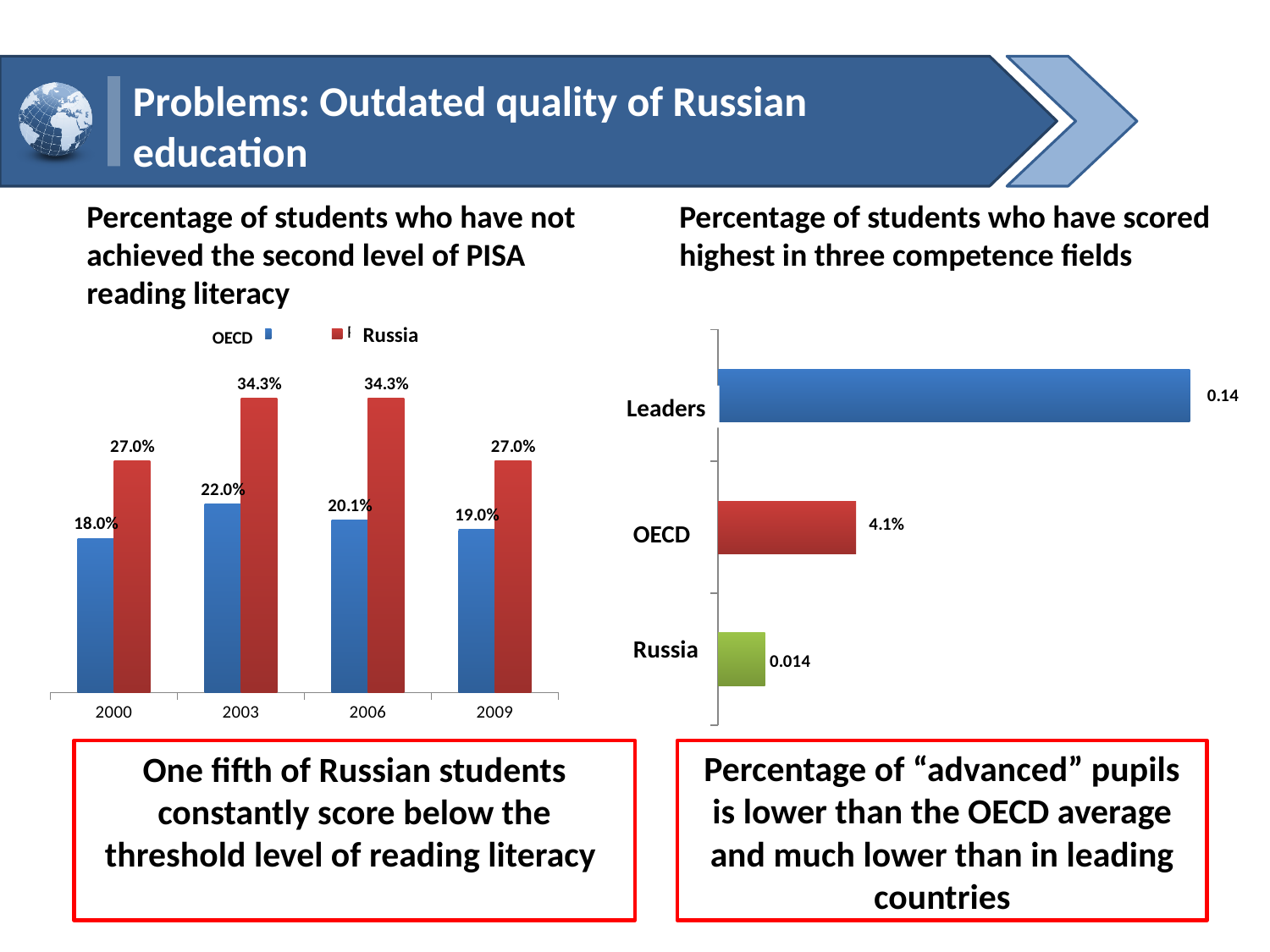
In the left chart, which is larger in 2000: the OECD value or the Russia value? Russia In the left chart, how many years are shown on the x axis? 4 What kind of chart is the right chart? Bar chart In the left chart, how many series does the legend list? 2 In the left chart (percentage of students who have not achieved the second level of PISA reading literacy), what is the value for Russia in 2003? 34.3% In the right chart, which category has the longest bar? Leaders In the left chart, what is the value for OECD in 2006? 20.1% In the left chart, what is the difference between the Russia and OECD values in 2009? 8.0% In the left chart, in which year is the OECD value highest? 2003 In the right chart, what is the value for Russia? 0.014 In the left chart, what is the value for OECD in 2000? 18.0% In the right chart (percentage of students who have scored highest in three competence fields), what is the value for OECD? 4.1%